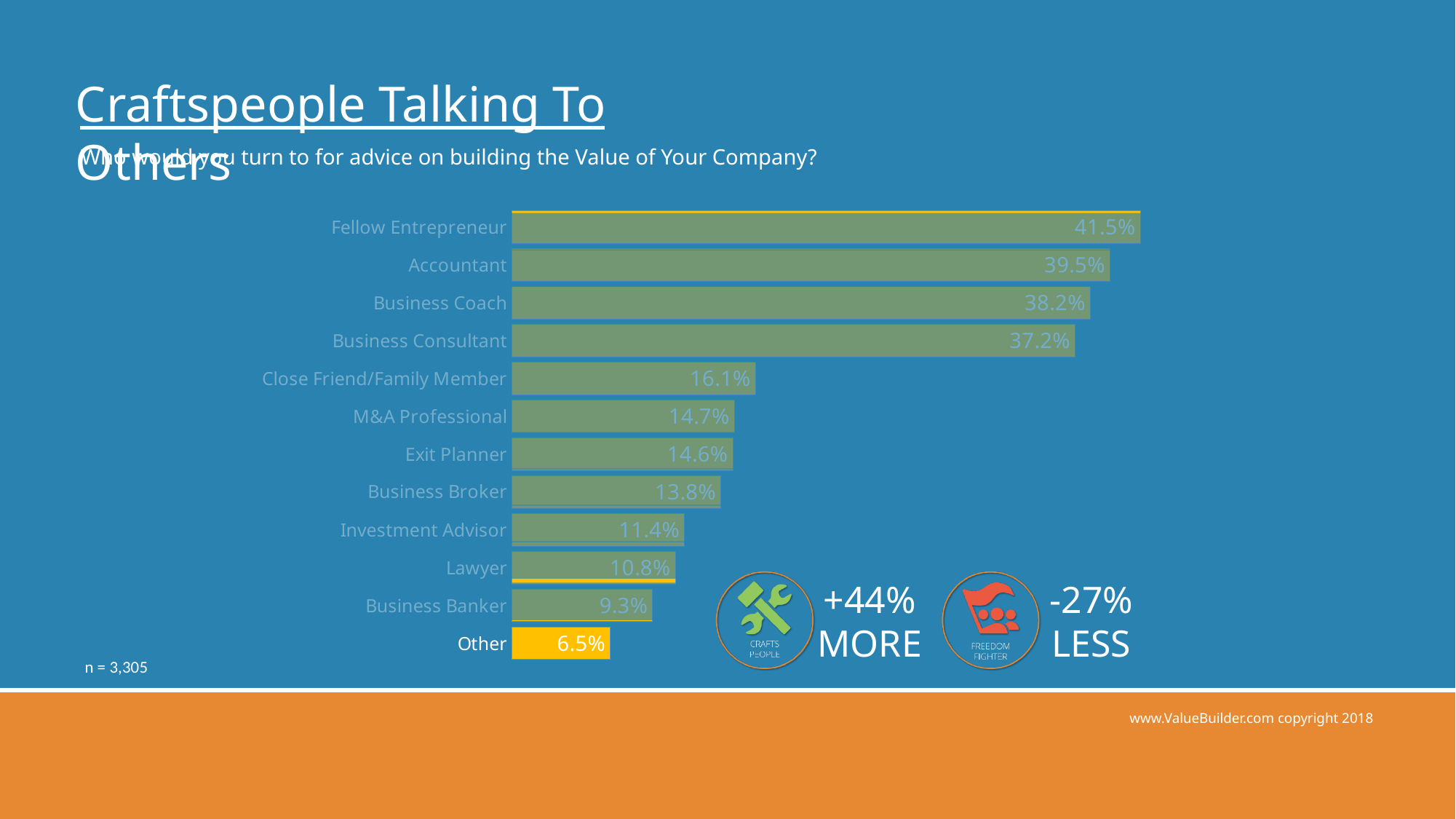
What is the difference between the values for Business Coach and Lawyer? 27.4% What is the value shown for Accountant? 39.5% What kind of chart is shown on the slide? Bar chart What is the value shown for Close Friend/Family Member? 16.1% What is the difference between the values for Fellow Entrepreneur and Accountant? 2.0% Which category has the highest value in the chart? Fellow Entrepreneur Which bar is highlighted in a different colour (yellow) from the others? Other What is the value shown for Business Banker? 9.3% Which category has the lowest value in the chart? Other How many categories are shown in the chart? 12 What percentage of respondents would turn to a Fellow Entrepreneur for advice? 41.5% Which has a larger value, Business Consultant or Close Friend/Family Member? Business Consultant